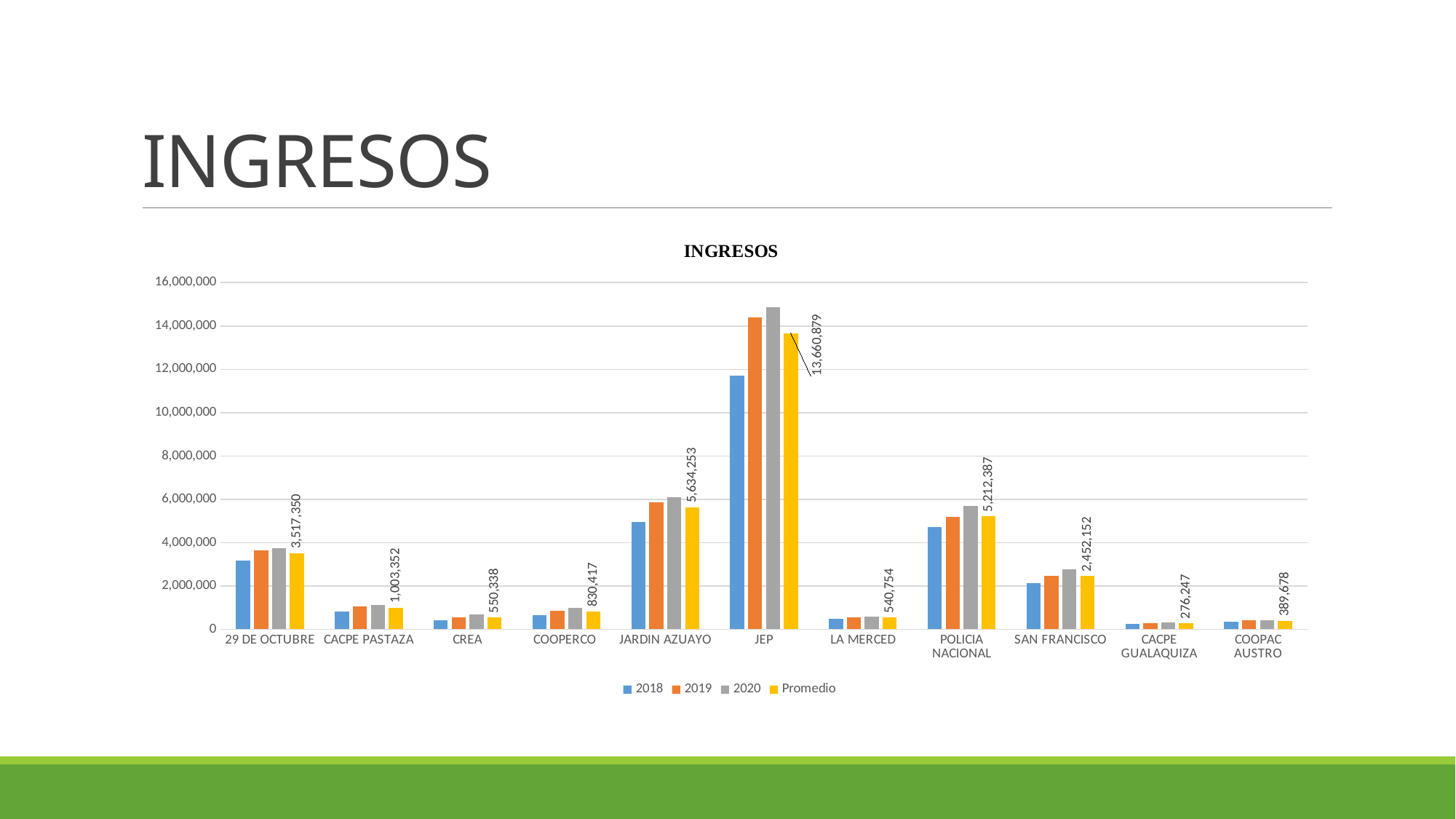
What is the Promedio value for JARDIN AZUAYO? 5,634,253 Which has a larger Promedio value, CREA or COOPERCO? COOPERCO What is the difference between the Promedio values for JARDIN AZUAYO and POLICIA NACIONAL? 421,866 How many series does the legend list? 4 What is the Promedio value for CACPE GUALAQUIZA? 276,247 Which category has the highest Promedio value? JEP Is the 2020 value for JEP greater or less than 14,000,000? greater What kind of chart is shown on the slide? Bar chart How many categories are shown on the x axis? 11 What is the Promedio value for JEP? 13,660,879 Which category has the lowest Promedio value? CACPE GUALAQUIZA Is the 2018 value for 29 DE OCTUBRE greater or less than 4,000,000? less